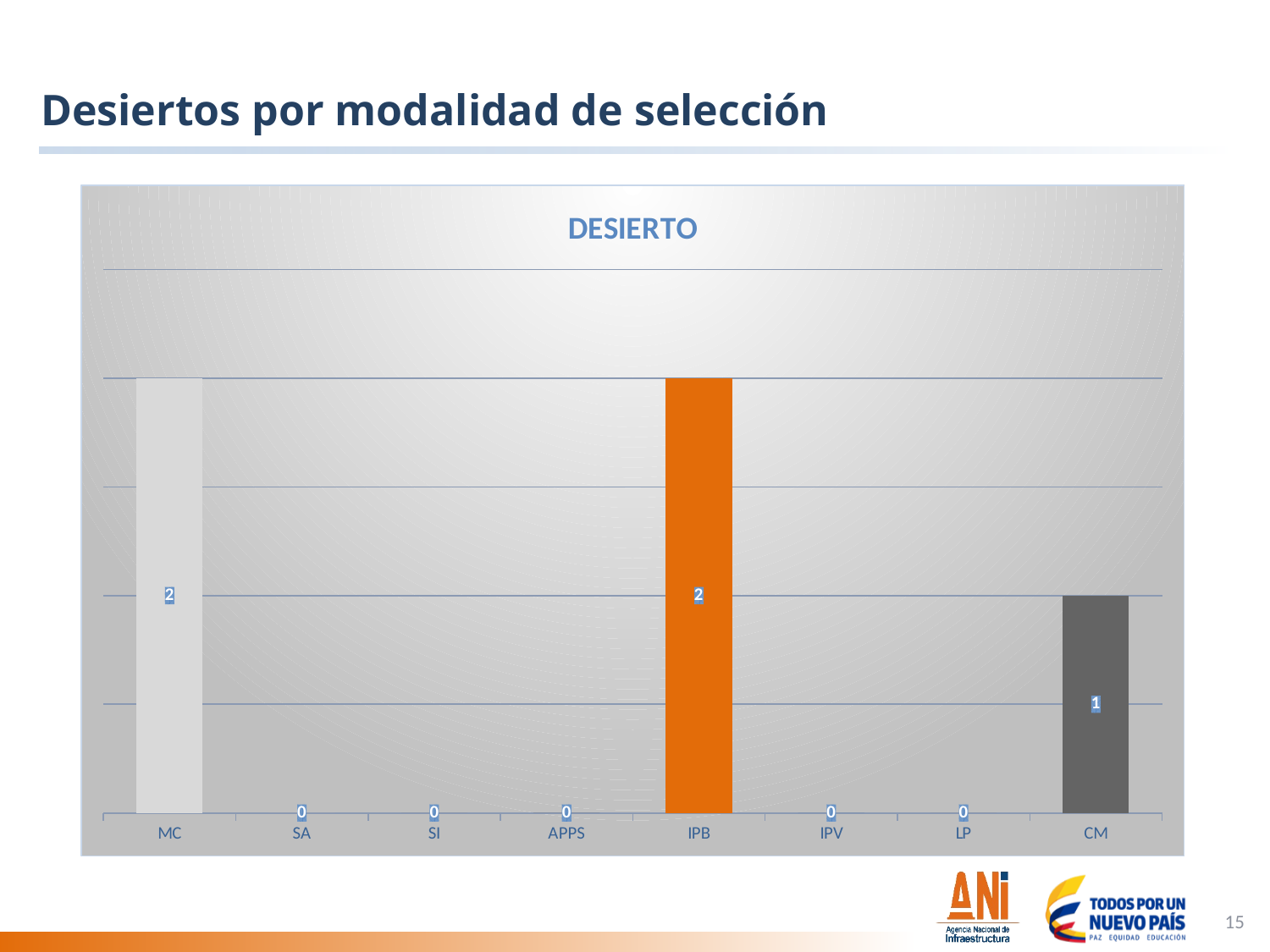
How many categories are shown on the x axis? 8 What is the value for IPB? 2 Which is larger, the value for CM or the value for IPV? CM What is the value for SA? 0 What is the value for LP? 0 What is the title of the chart? DESIERTO Which is larger, the value for IPB or the value for CM? IPB What is the difference between the values for MC and CM? 1 How many categories have a value of 0? 5 What is the value for CM? 1 What kind of chart is this? Bar chart What is the value for MC? 2